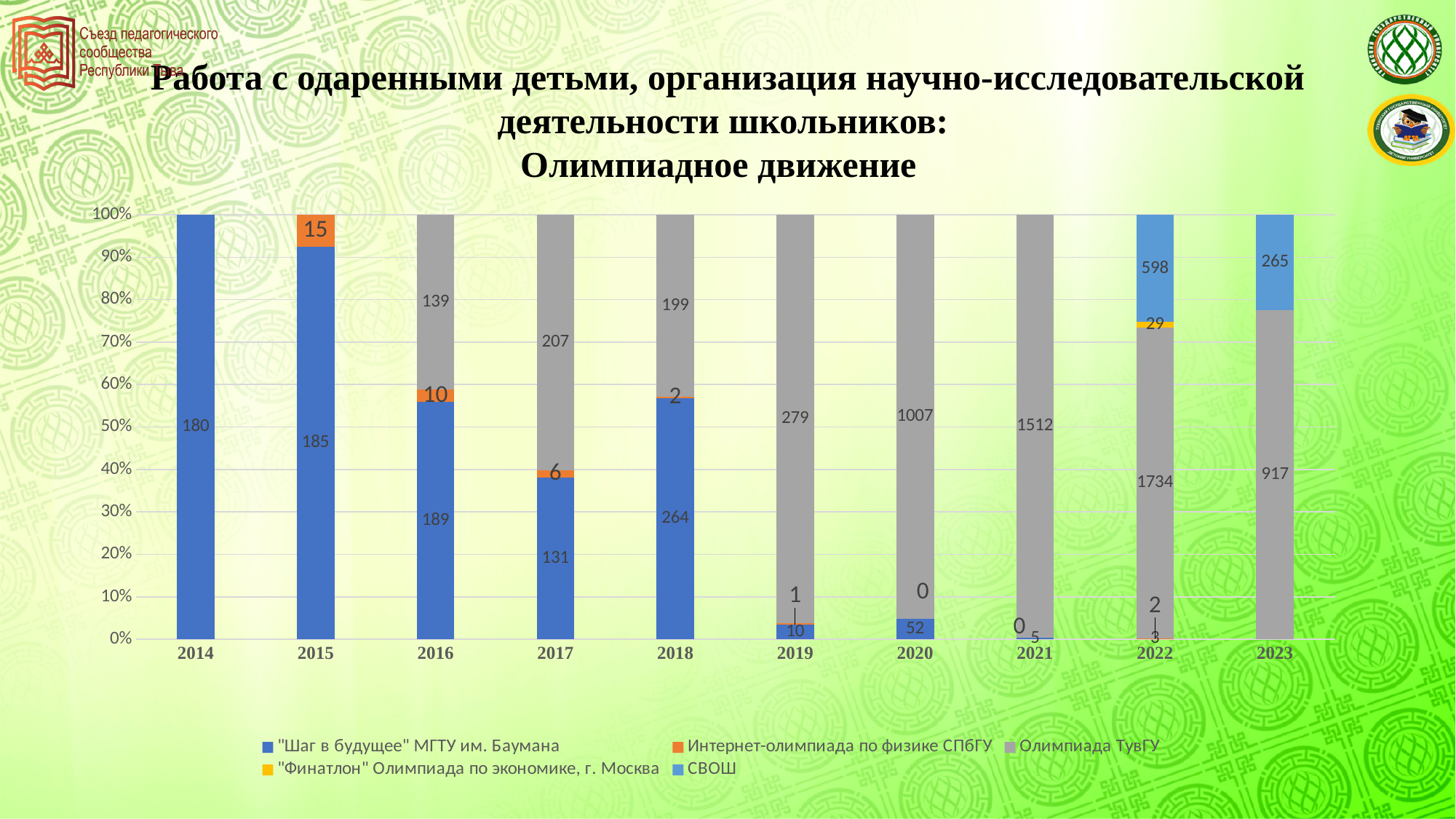
In which year is the value for "Шаг в будущее" МГТУ им. Баумана the lowest? 2022 What is the difference between the СВОШ values in 2022 and 2023? 333 What is the value for Олимпиада ТувГУ in 2022? 1734 Which is larger: the Олимпиада ТувГУ value in 2020 or in 2021? 2021 What kind of chart is shown on the slide? Stacked bar chart How many years are shown on the x axis of the chart? 10 What is the value for "Шаг в будущее" МГТУ им. Баумана in 2018? 264 What is the total of the stacked bar for 2023? 1182 What is the value for Интернет-олимпиада по физике СПбГУ in 2015? 15 What is the value for СВОШ in 2023? 265 How many series does the chart legend list? 5 In which year is the value for Олимпиада ТувГУ the highest? 2022